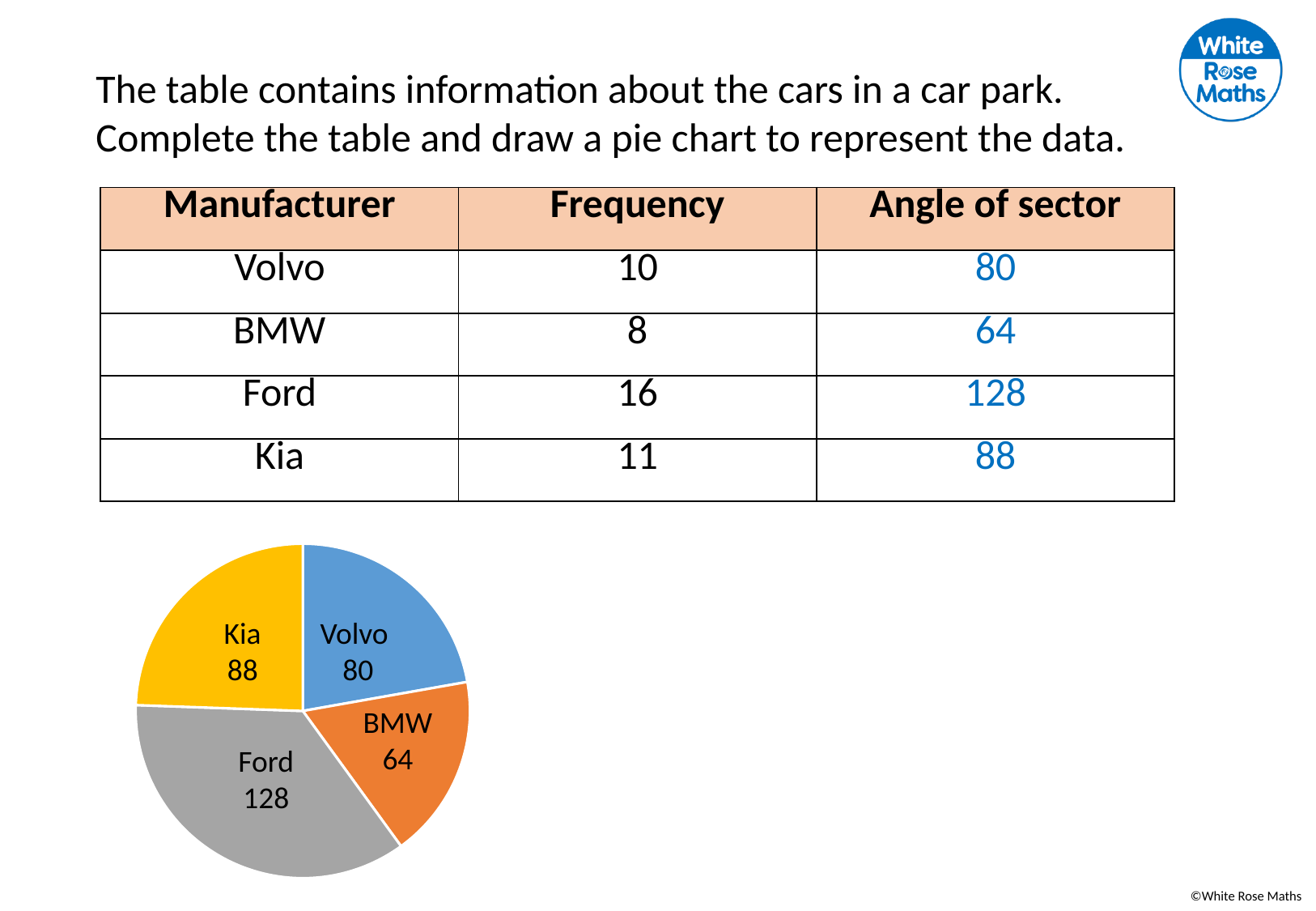
What colour is the Ford slice in the pie chart? grey Which manufacturer has the smallest slice of the pie chart? BMW What is the difference between the values for Kia and Volvo in the pie chart? 8 How many slices does the pie chart have? 4 What is the difference between the values for Ford and BMW in the pie chart? 64 What value is shown for the Kia slice of the pie chart? 88 What value is shown for the Ford slice of the pie chart? 128 What value is shown for the BMW slice of the pie chart? 64 Which manufacturer has the largest slice of the pie chart? Ford What value is shown for the Volvo slice of the pie chart? 80 What type of chart is shown on the slide? pie chart Which slice is larger in the pie chart, Kia or Volvo? Kia